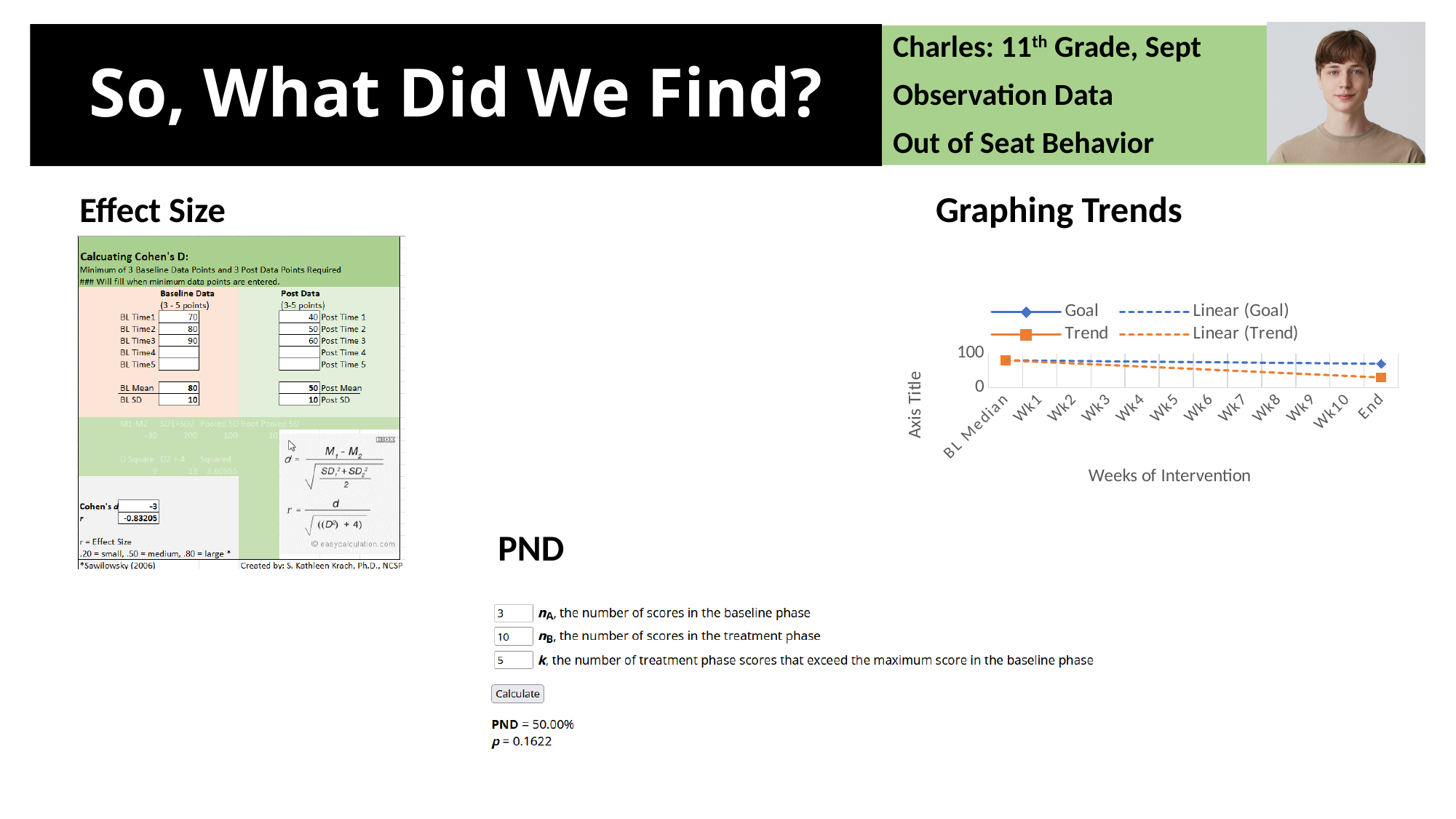
What kind of chart is shown under "Graphing Trends"? line chart In the "Graphing Trends" chart, which is larger for the Trend series: the value at BL Median or the value at End? BL Median How many entries does the legend of the "Graphing Trends" chart list? 4 In the "Graphing Trends" chart, is the Goal value at End greater or less than 100? less In the "Graphing Trends" chart, what is the first category on the x axis? BL Median In the "Graphing Trends" chart, what is the last category on the x axis? End What is the x-axis title of the "Graphing Trends" chart? Weeks of Intervention In the "Graphing Trends" chart, does the Trend series rise or fall from BL Median to End? fall How many categories are shown on the x axis of the "Graphing Trends" chart? 12 In the "Graphing Trends" chart, is the Trend value at End greater or less than 100? less In the "Graphing Trends" chart, is the Trend value at BL Median greater or less than 0? greater In the "Graphing Trends" chart, which series is larger at End: Goal or Trend? Goal